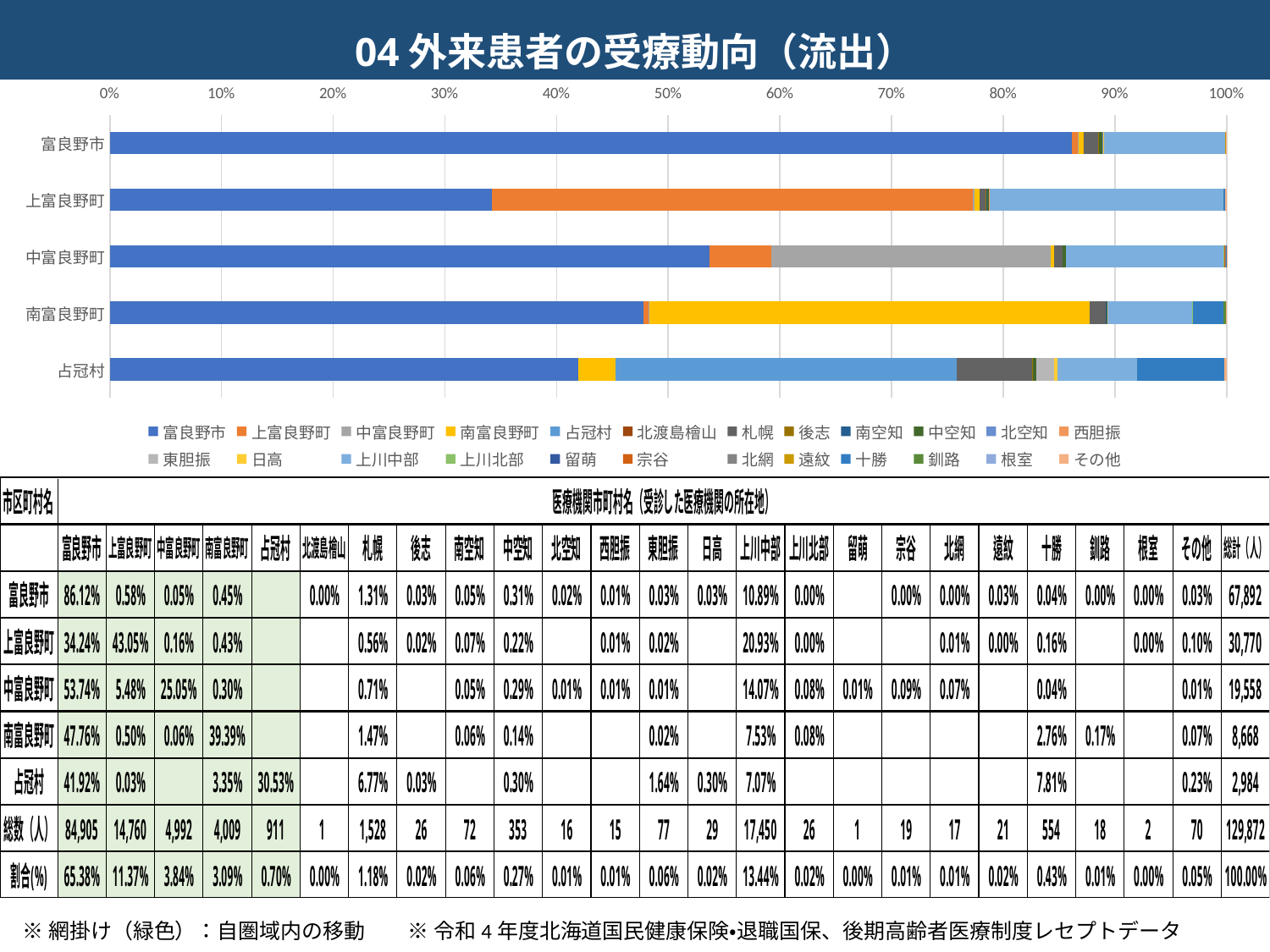
What is the difference between the 富良野市 share for 富良野市 (86.12%) and for 上富良野町 (34.24%)? 51.88% Which municipality has the largest 富良野市 (dark blue) segment in its bar? 富良野市 Which municipality has the smallest 富良野市 (dark blue) segment in its bar? 上富良野町 According to the table, what share of 占冠村 outpatients received care in 十勝? 7.81% Is the 富良野市 segment of the 富良野市 bar greater or less than 80%? greater How many series does the chart legend list? 24 What type of chart is shown on the slide? Stacked horizontal bar chart Is the 富良野市 segment of the 占冠村 bar greater or less than 50%? less According to the table, what share of 富良野市 outpatients received care in 富良野市? 86.12% According to the table, what share of 上富良野町 outpatients received care in 上川中部? 20.93% Which has the larger 富良野市 segment, 中富良野町 or 南富良野町? 中富良野町 How many municipalities (categories) are plotted on the vertical axis of the chart? 5